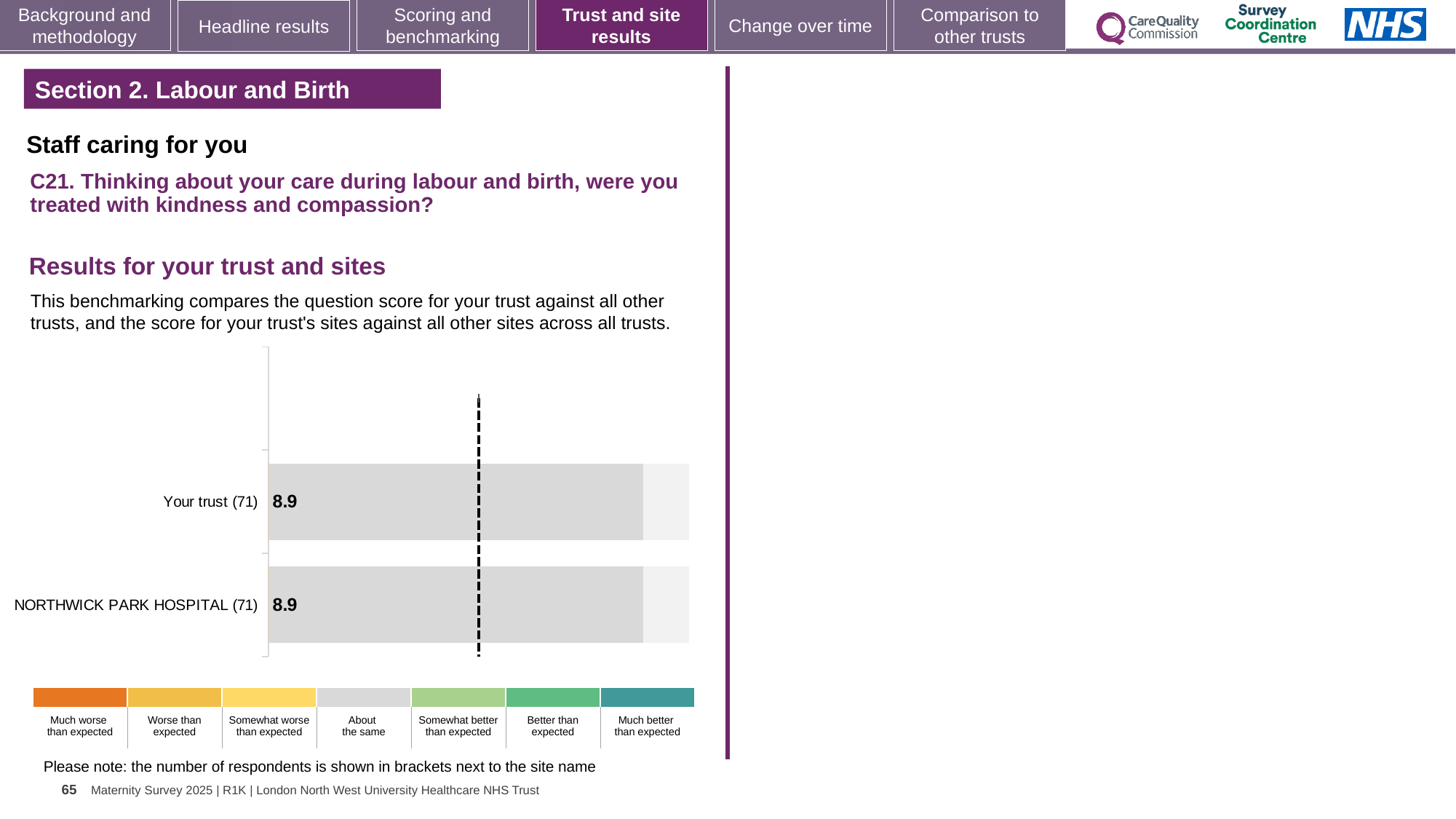
What is the difference between the score for Your trust and the score for NORTHWICK PARK HOSPITAL? 0 What is the score for Your trust in the chart? 8.9 Which question does the chart report results for? C21. Thinking about your care during labour and birth, were you treated with kindness and compassion? How many benchmark categories are listed in the colour key below the chart? 7 What is the score for NORTHWICK PARK HOSPITAL in the chart? 8.9 How many bars are plotted in the chart? 2 What kind of chart is shown on the slide? Bar chart How many respondents are shown in brackets next to Your trust? 71 How many respondents are shown in brackets next to NORTHWICK PARK HOSPITAL? 71